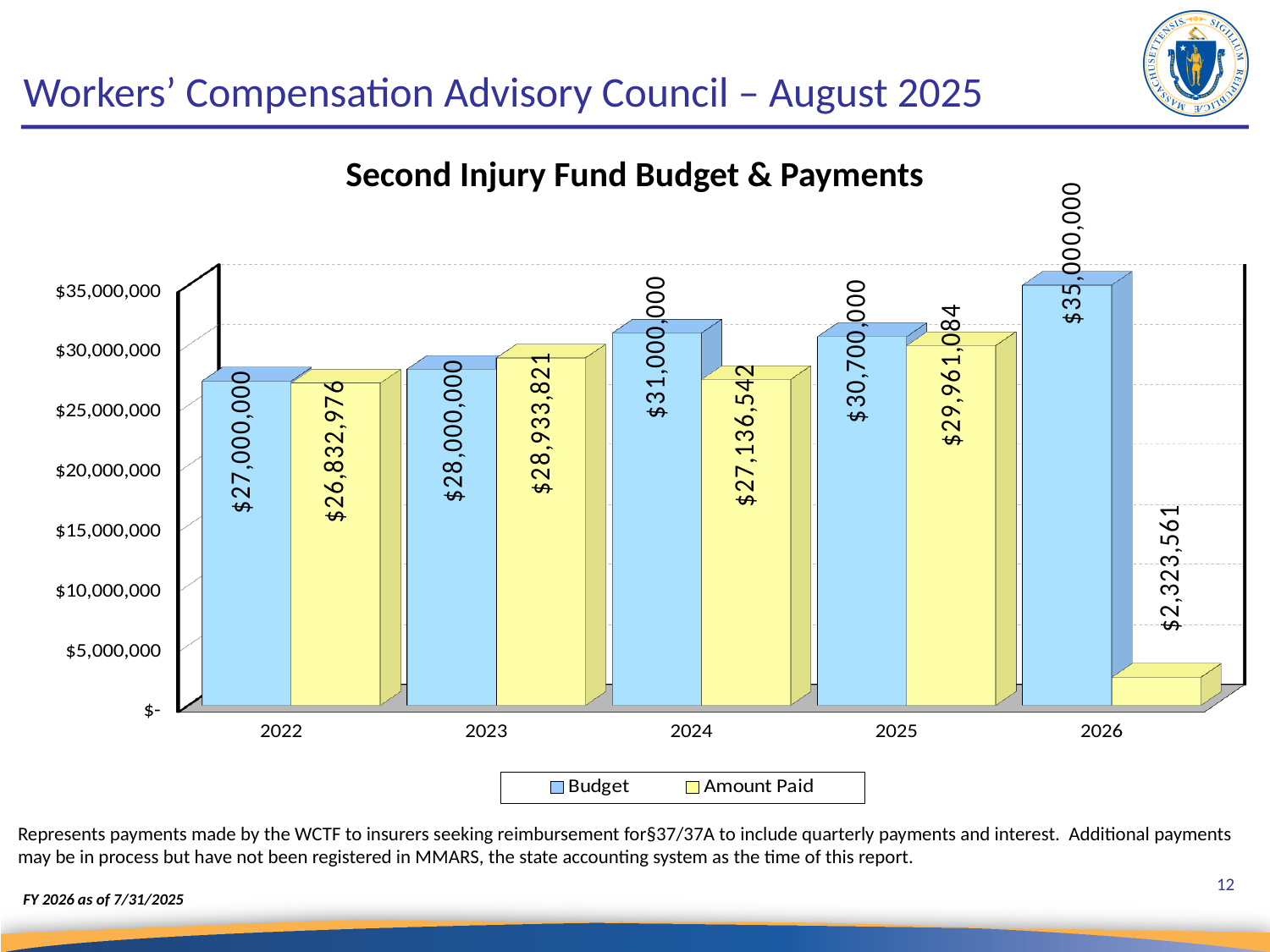
What is the Amount Paid for 2025? $29,961,084 How many series does the legend list? 2 What is the difference between the Budget and the Amount Paid in 2024? $3,863,458 Is the Amount Paid for 2026 greater or less than $5,000,000? less How many years are shown on the x axis? 5 What is the Amount Paid for 2026? $2,323,561 What is the title of the chart? Second Injury Fund Budget & Payments What is the Budget value for 2024? $31,000,000 Which year has the highest Budget? 2026 What kind of chart is shown? bar chart In 2023, which is larger, the Budget or the Amount Paid? Amount Paid Which year has the lowest Amount Paid? 2026